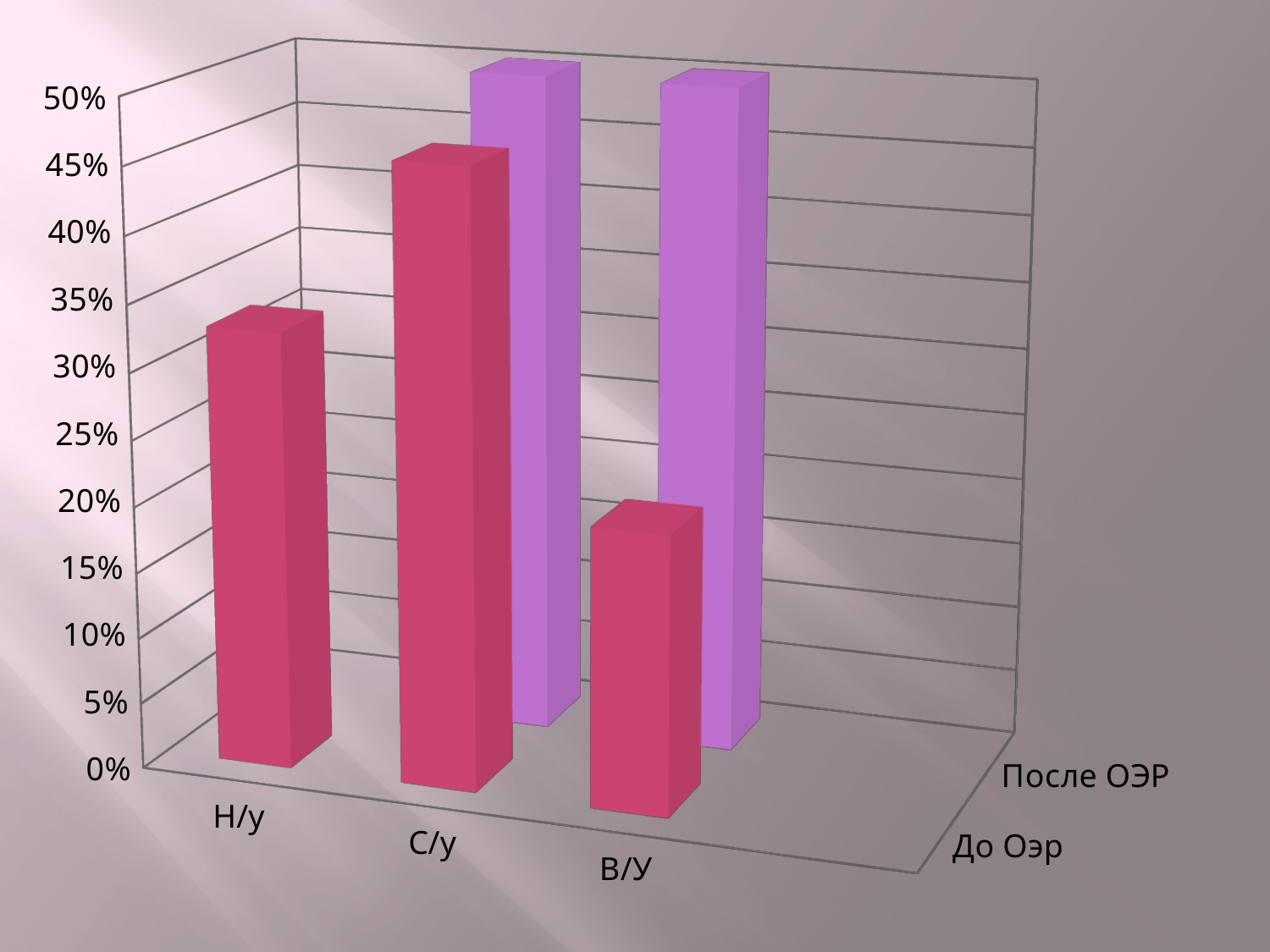
How many categories are shown along the x axis? 3 Is the value for В/У in the После ОЭР series greater or less than 40%? greater For В/У, which series has the larger value: До Оэр or После ОЭР? После ОЭР Which category has the lowest value in the До Оэр series? В/У Is the value for Н/у in the До Оэр series greater or less than 40%? less What kind of chart is shown on the slide? bar chart Is the value for В/У in the До Оэр series greater or less than 30%? less What colour are the bars of the После ОЭР series? purple In the До Оэр series, which is larger: the value for Н/у or the value for В/У? Н/у How many series does the chart show? 2 Which category has the highest value in the До Оэр series? С/у